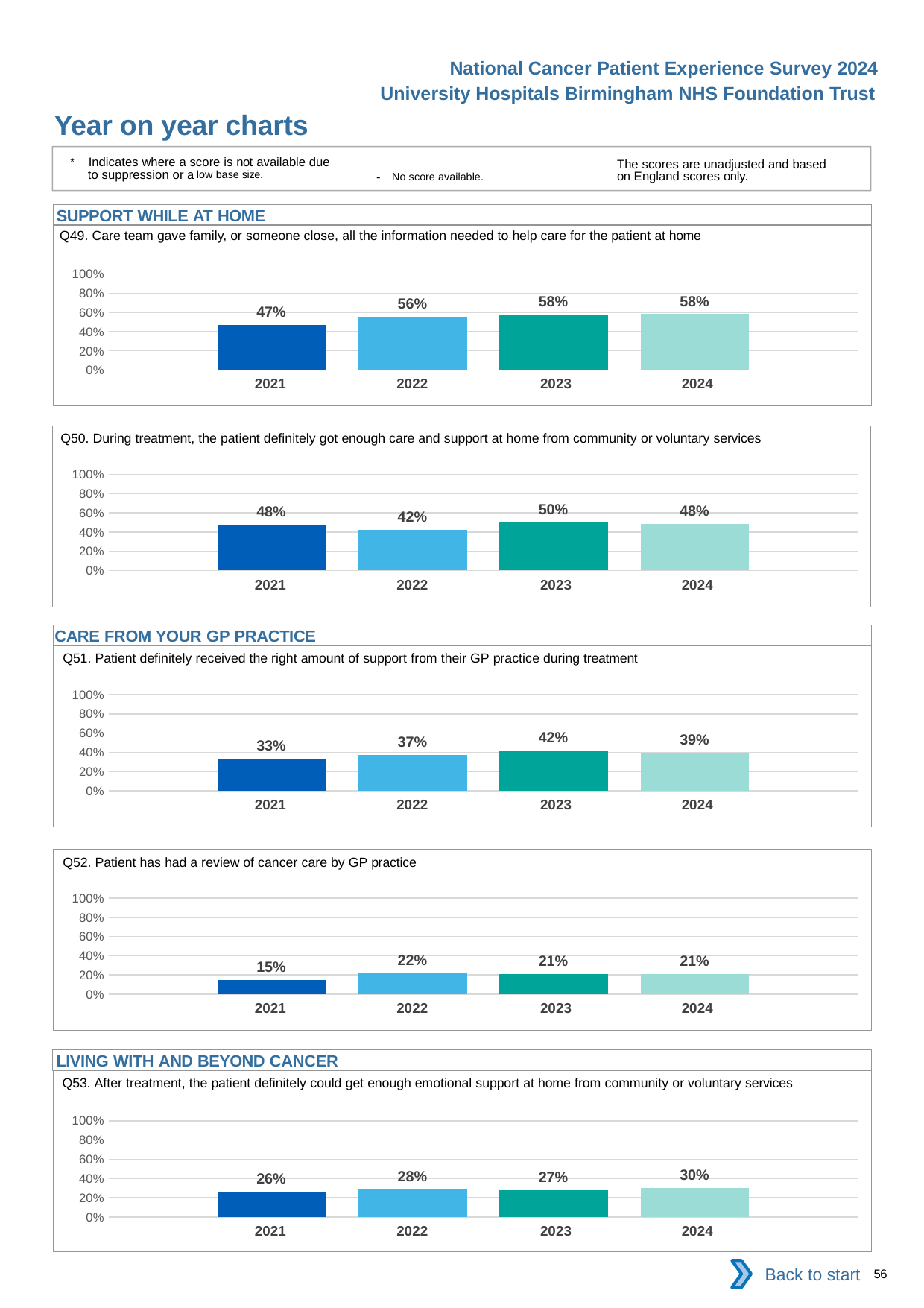
In the Q52 chart, what is the value for 2021? 15% In the Q50 chart, which year has the lowest value? 2022 In the Q50 chart, what is the value for 2023? 50% What kind of chart is the Q52 chart? bar chart In the Q49 chart, what is the value for 2021? 47% In the Q51 chart, which year has the highest value? 2023 In the Q53 chart, what is the value for 2024? 30% In the Q53 chart, which year has the lowest value? 2021 In the Q51 chart, what is the difference between the 2023 value and the 2021 value? 9% In the Q52 chart, is the value for 2022 larger or smaller than the value for 2021? larger How many years are shown on the x axis of the Q49 chart? 4 In the Q49 chart, what is the difference between the 2024 value and the 2021 value? 11%